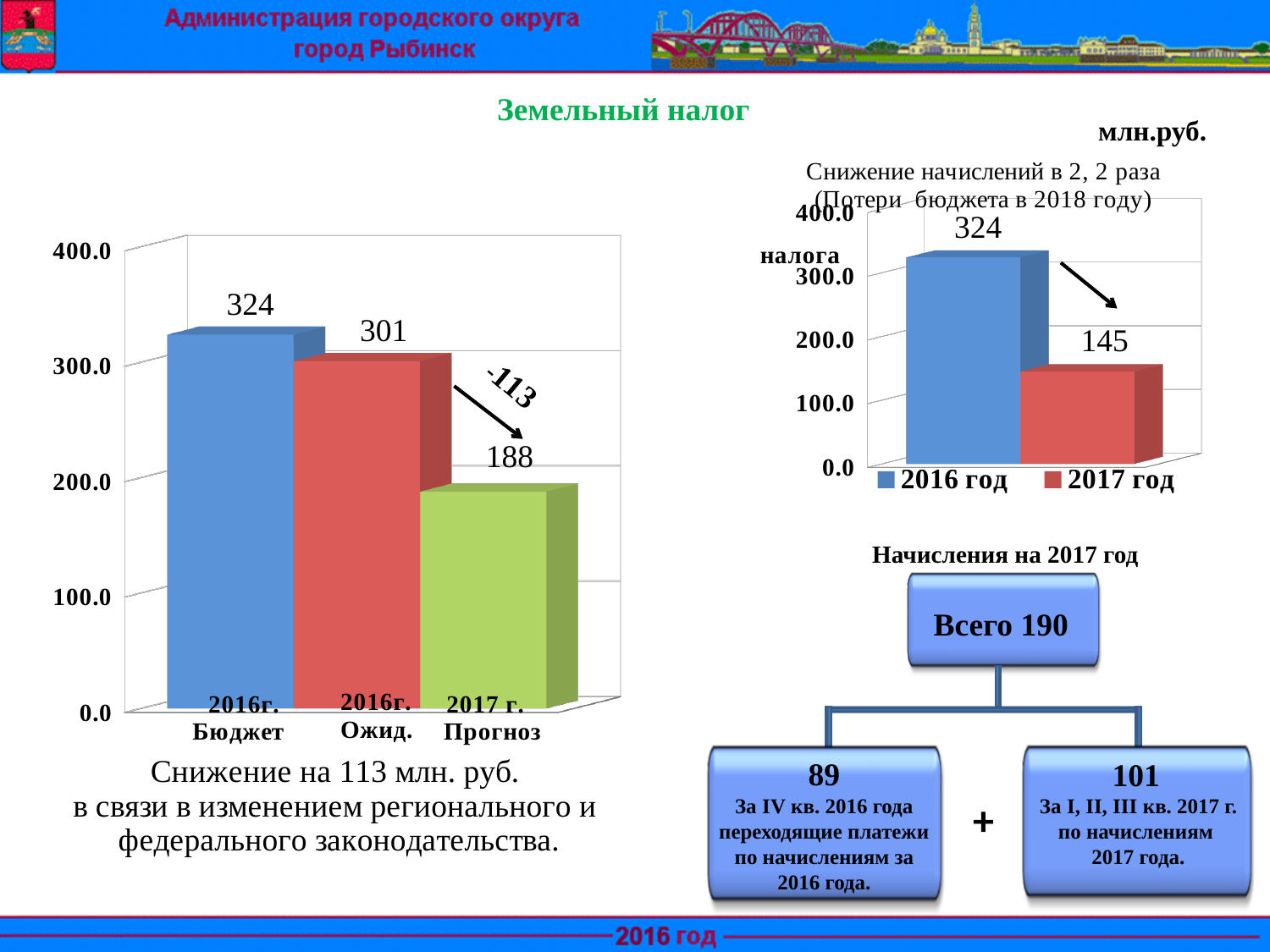
On the left chart, which category has the highest value? 2016г. Бюджет On the right chart, what is the value for 2017 год? 145 On the left chart, what is the value for 2017 г. Прогноз? 188 On the right chart, what is the difference between the values for 2016 год and 2017 год? 179 On the left chart, what is the difference between the values for 2016г. Ожид. and 2017 г. Прогноз? 113 On the left chart, how many bars are plotted? 3 On the left chart, what is the value for 2016г. Ожид.? 301 On the left chart, what is the value for 2016г. Бюджет? 324 On the left chart, which category has the lowest value? 2017 г. Прогноз On the left chart, do the values rise or fall from left to right? fall On the right chart, how many entries does the legend list? 2 What kind of chart is the left chart? bar chart